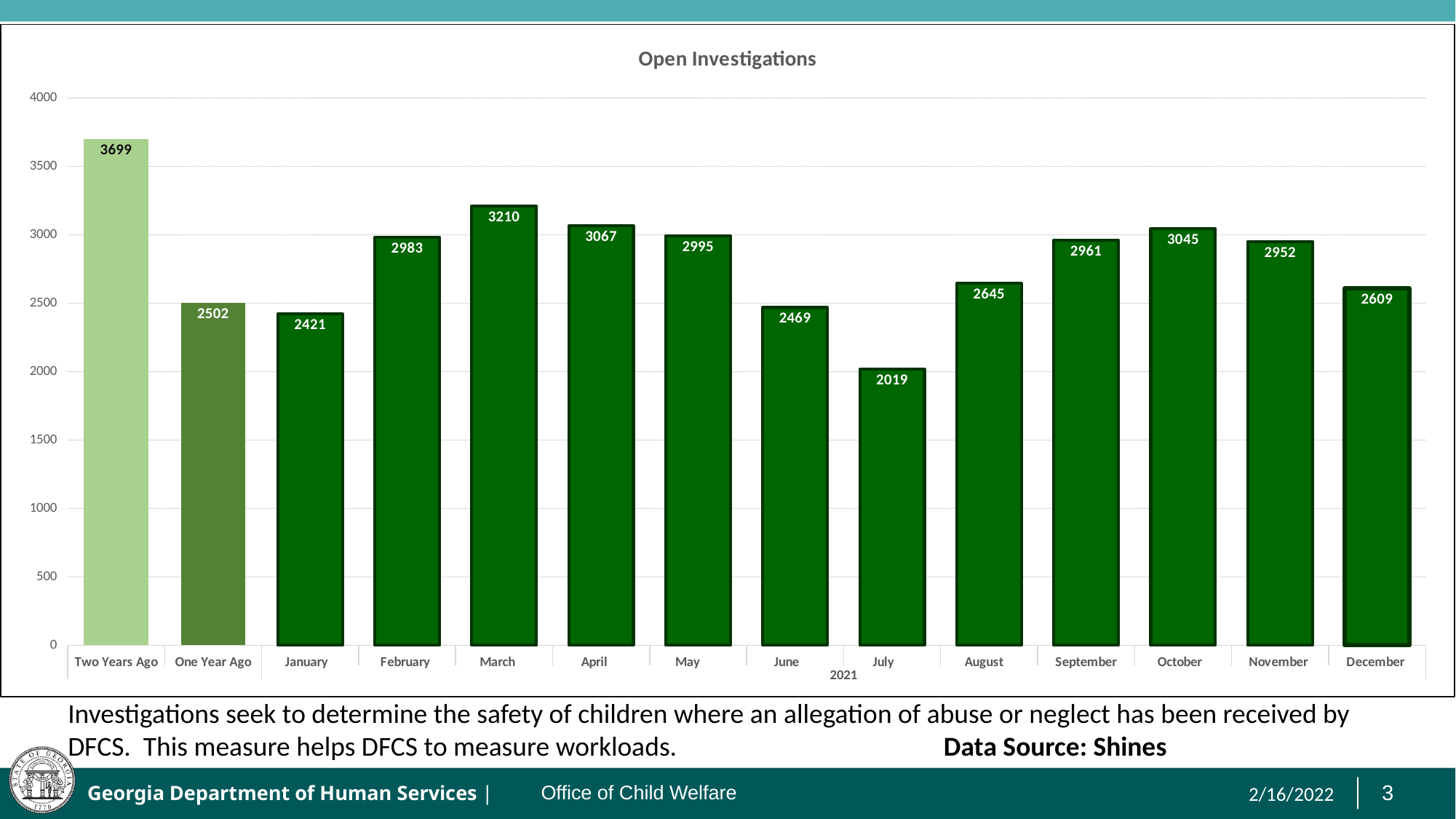
Which category has the lowest value? July How many bars are shown in the chart? 14 What is the difference between the values for Two Years Ago and One Year Ago? 1197 What is the value for Two Years Ago? 3699 What kind of chart is this? Bar chart What is the value for March? 3210 Which category has the highest value? Two Years Ago What is the title of the chart? Open Investigations What is the value for July? 2019 Which is larger, the value for April or the value for October? April Which month of 2021 has the highest value? March What is the difference between the values for March and July? 1191